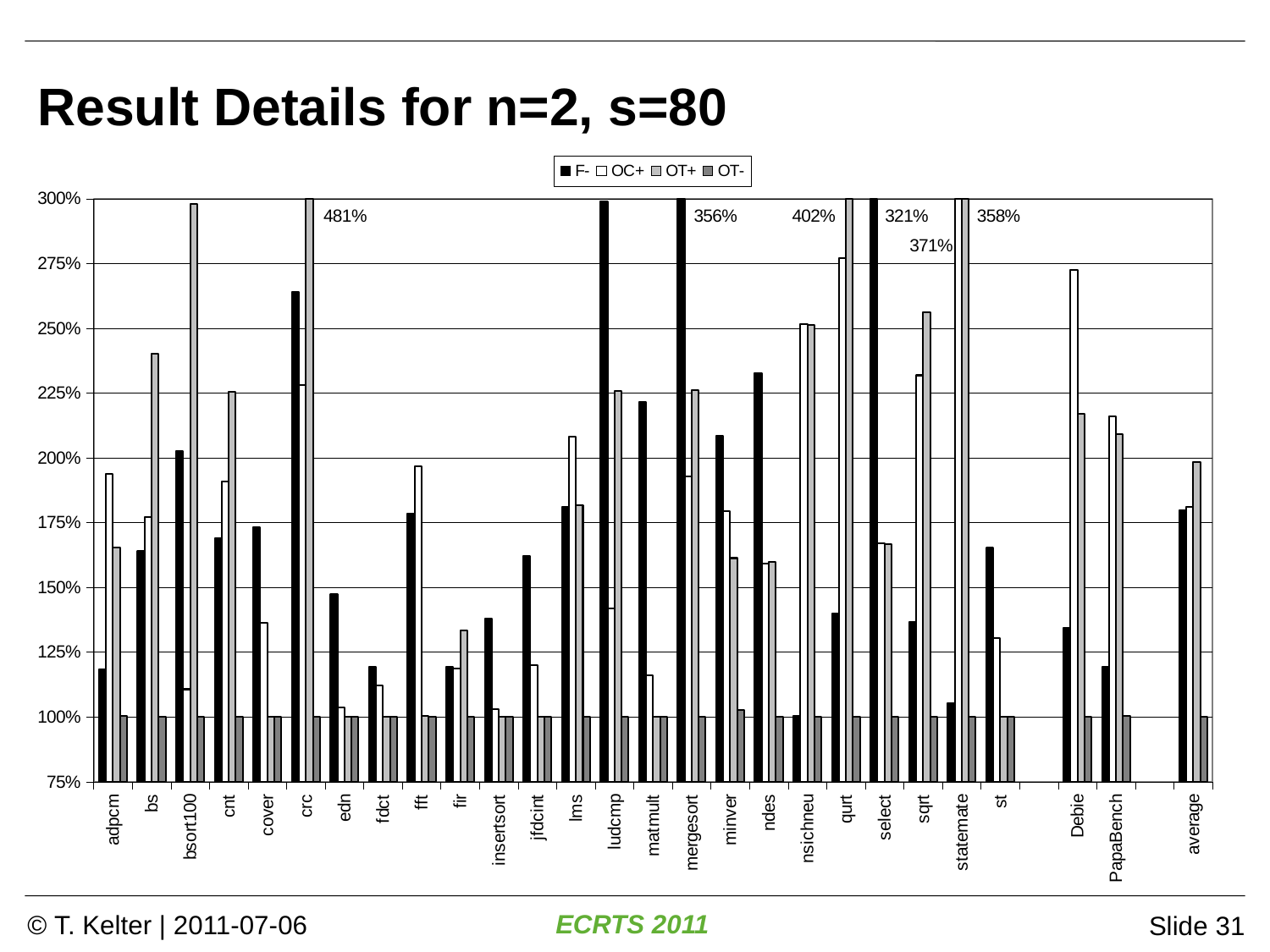
Is the OC+ value for Debie greater or less than 250%? greater For bs, which is larger, the F- value or the OT+ value? OT+ What is the largest value printed as a data label on the chart? 481% Is the F- value for ndes greater or less than 225%? greater For adpcm, which is larger, the F- value or the OC+ value? OC+ How many categories are shown along the x axis? 27 How many series does the legend list? 4 What is the OT- value for adpcm? 100% Is the F- value for adpcm greater or less than 125%? less What are the series names listed in the legend? F-, OC+, OT+, OT- What is the title of the chart? Result Details for n=2, s=80 What kind of chart is shown on the slide? bar chart